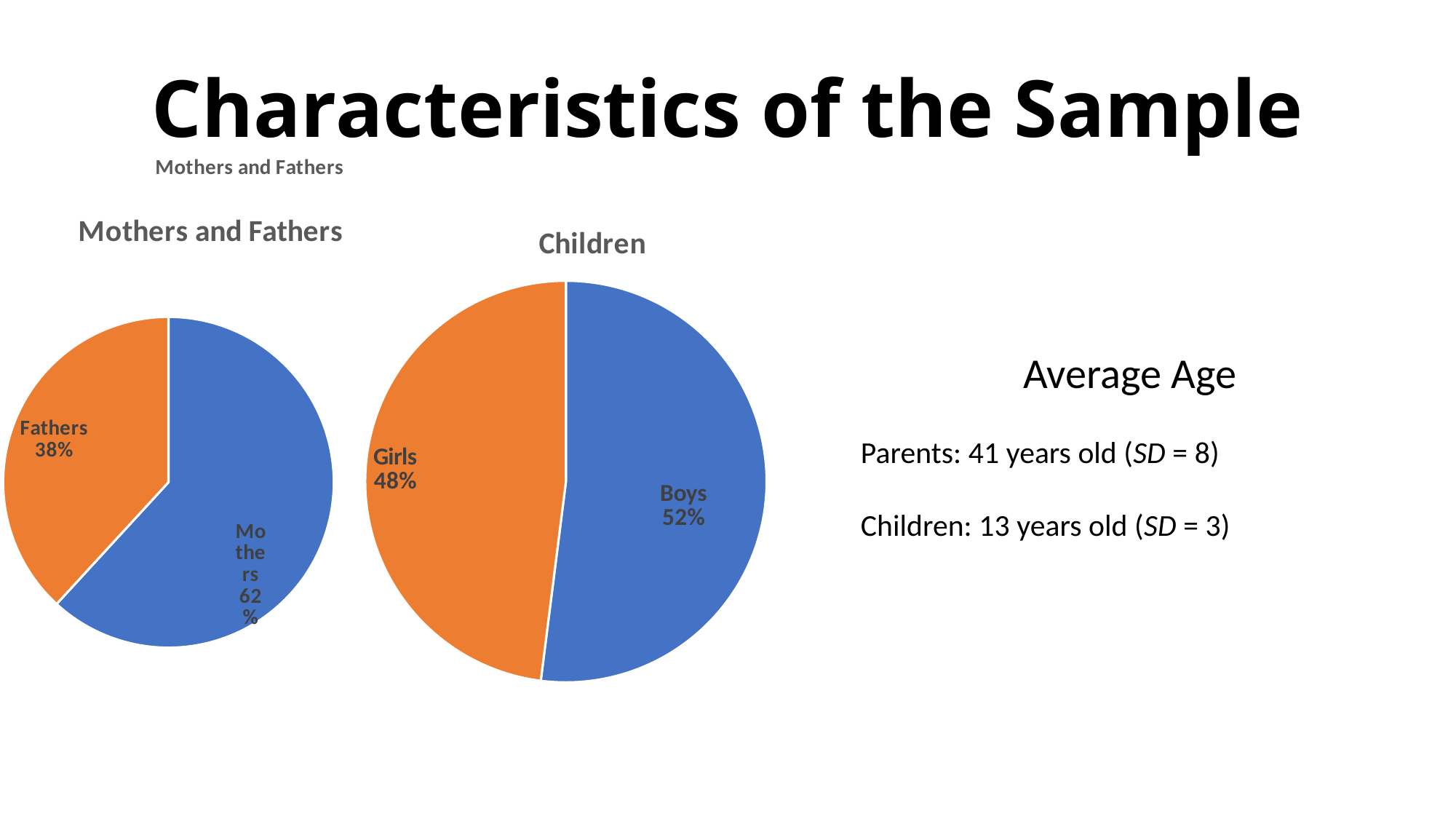
In the 'Mothers and Fathers' chart, what share of the pie is Fathers? 38% How many slices does the 'Mothers and Fathers' chart have? 2 In the 'Children' chart, what share of the pie is Girls? 48% In the 'Children' chart, which is larger, Boys or Girls? Boys In the 'Children' chart, what share of the pie is Boys? 52% What kind of chart is the 'Children' chart? Pie chart In the 'Mothers and Fathers' chart, what is the difference between the Mothers and Fathers shares? 24% In the 'Children' chart, what colour is the Boys slice? Blue In the 'Children' chart, what is the difference between the Boys and Girls shares? 4% In the 'Mothers and Fathers' chart, which slice is the largest? Mothers In the 'Children' chart, which slice is the smallest? Girls